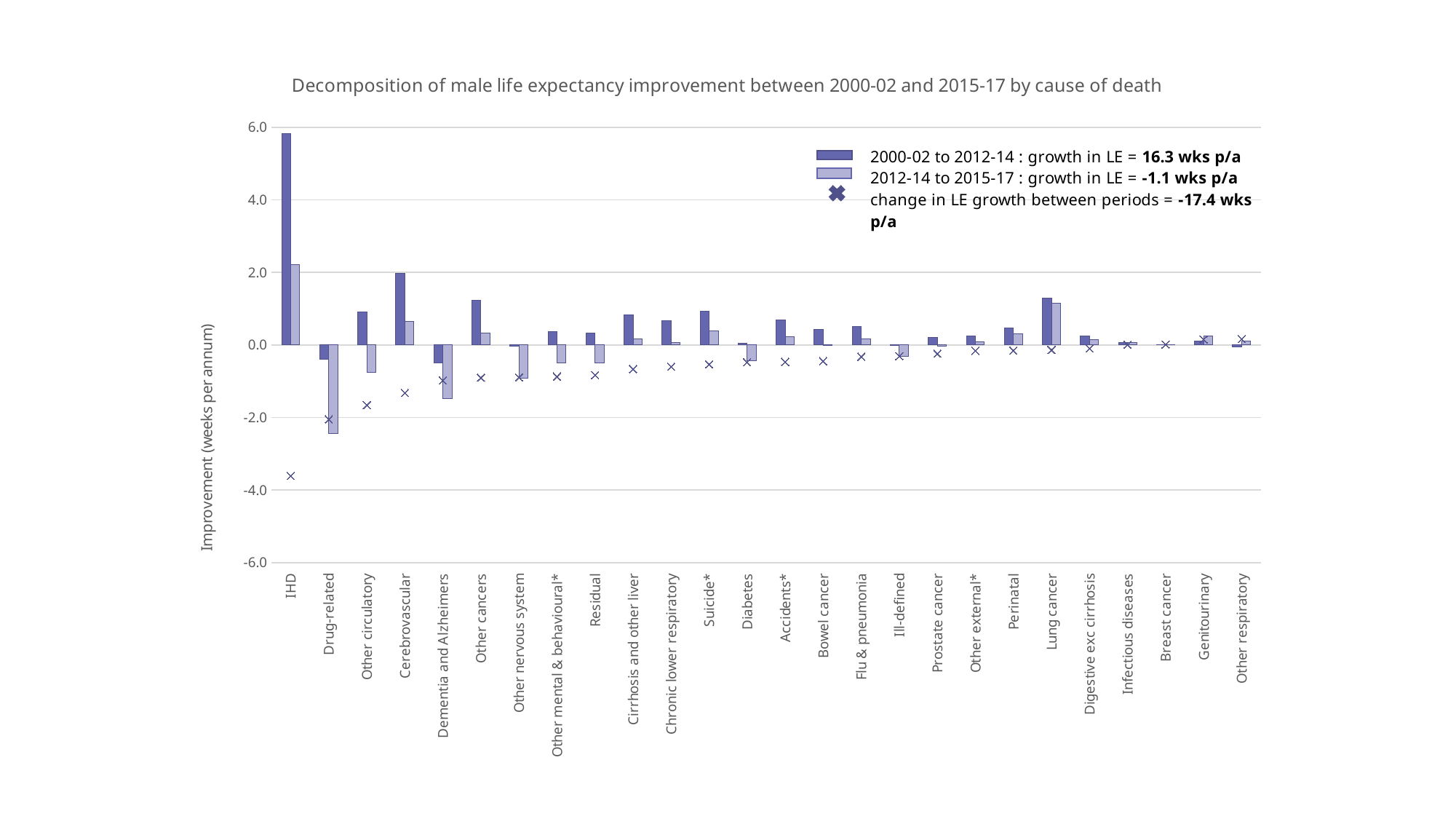
Is the 2000-02 to 2012-14 value for IHD greater or less than 4.0? greater How many causes of death are shown along the x axis? 26 According to the legend, what was the growth in LE for 2000-02 to 2012-14? 16.3 wks p/a What kind of chart is shown on the slide? Bar chart For the 2000-02 to 2012-14 series, which is larger: Cerebrovascular or Other circulatory? Cerebrovascular For the 2012-14 to 2015-17 series, which is larger: Lung cancer or Other cancers? Lung cancer Is the 2000-02 to 2012-14 value for Cerebrovascular greater or less than 1.0? greater Which cause of death has the lowest 'change in LE growth between periods' marker? IHD Which cause of death has the lowest value for the 2012-14 to 2015-17 series? Drug-related How many series does the legend list? 3 Is the 2012-14 to 2015-17 value for Drug-related greater or less than -2.0? less Which cause of death has the highest value for the 2000-02 to 2012-14 series? IHD